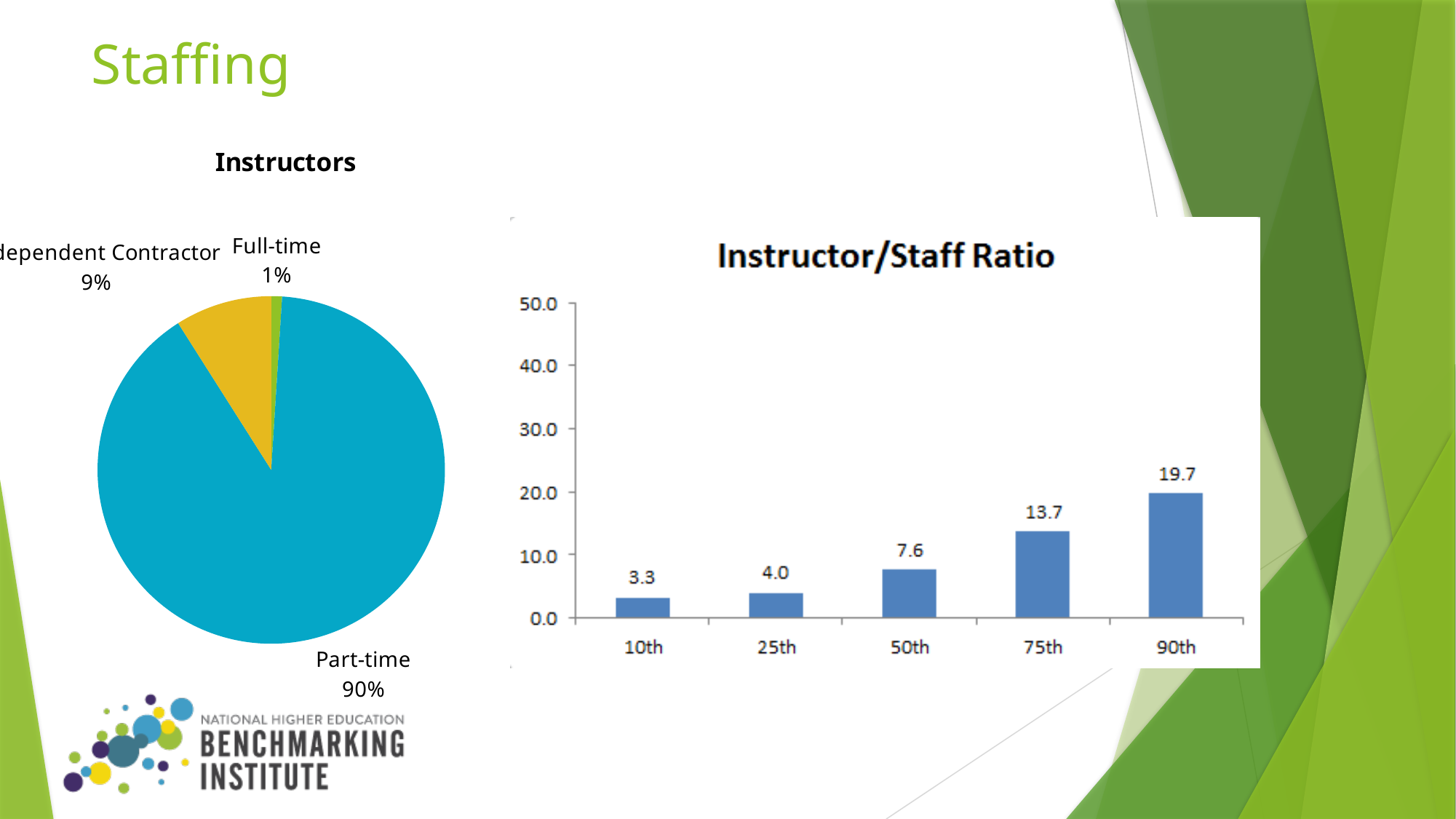
In the Instructor/Staff Ratio chart, what is the value for the 90th percentile? 19.7 In the Instructors pie chart, which category has the largest slice? Part-time In the Instructors pie chart, what share is Part-time? 90% In the Instructors pie chart, which category has the smallest slice? Full-time In the Instructor/Staff Ratio chart, do the values rise or fall from the 10th to the 90th percentile? Rise In the Instructor/Staff Ratio chart, which percentile has the lowest value? 10th How many bars are in the Instructor/Staff Ratio chart? 5 What kind of chart is the Instructors chart? Pie chart In the Instructor/Staff Ratio chart, is the value for the 90th percentile greater or less than 20.0? less In the Instructors pie chart, what share is Full-time? 1% In the Instructor/Staff Ratio chart, what is the difference between the 75th and 25th percentile values? 9.7 In the Instructor/Staff Ratio chart, what is the value for the 50th percentile? 7.6